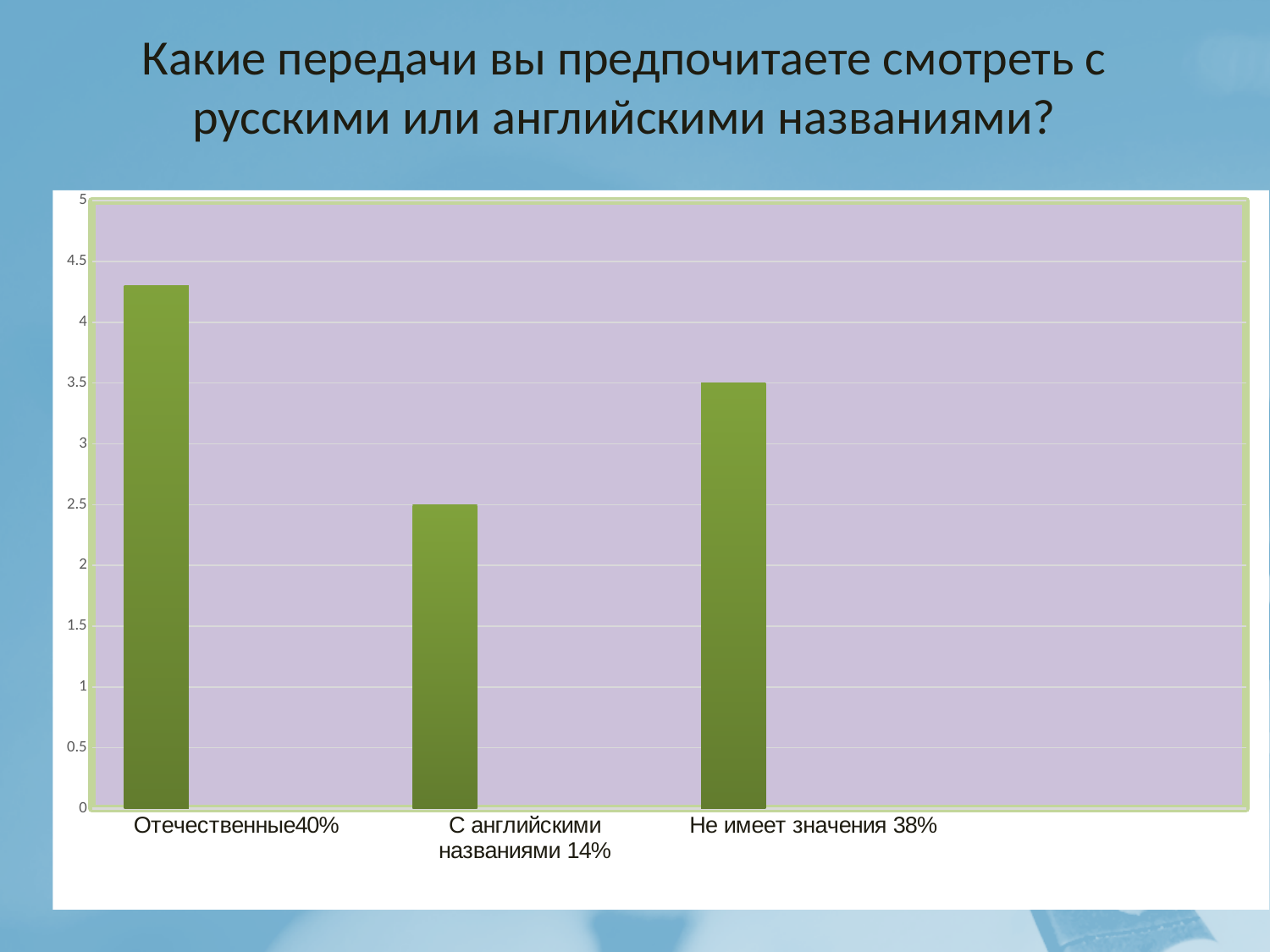
What value does the bar for 'Не имеет значения 38%' reach on the axis? 3.5 What is the maximum value shown on the vertical axis? 5 Is the value for 'Отечественные40%' greater or less than 4.5? less What type of chart is shown on the slide? bar chart Which category has the lowest bar? С английскими названиями 14% What is the difference between the bars for 'Не имеет значения 38%' and 'С английскими названиями 14%'? 1 What value does the bar for 'С английскими названиями 14%' reach on the axis? 2.5 What percentage is written in the category label for 'Не имеет значения'? 38% Which category has the highest bar? Отечественные40% Is the value for 'Отечественные40%' greater or less than 4? greater Which is larger, the bar for 'Отечественные40%' or the bar for 'Не имеет значения 38%'? Отечественные40% How many bars (categories) does the chart show? 3